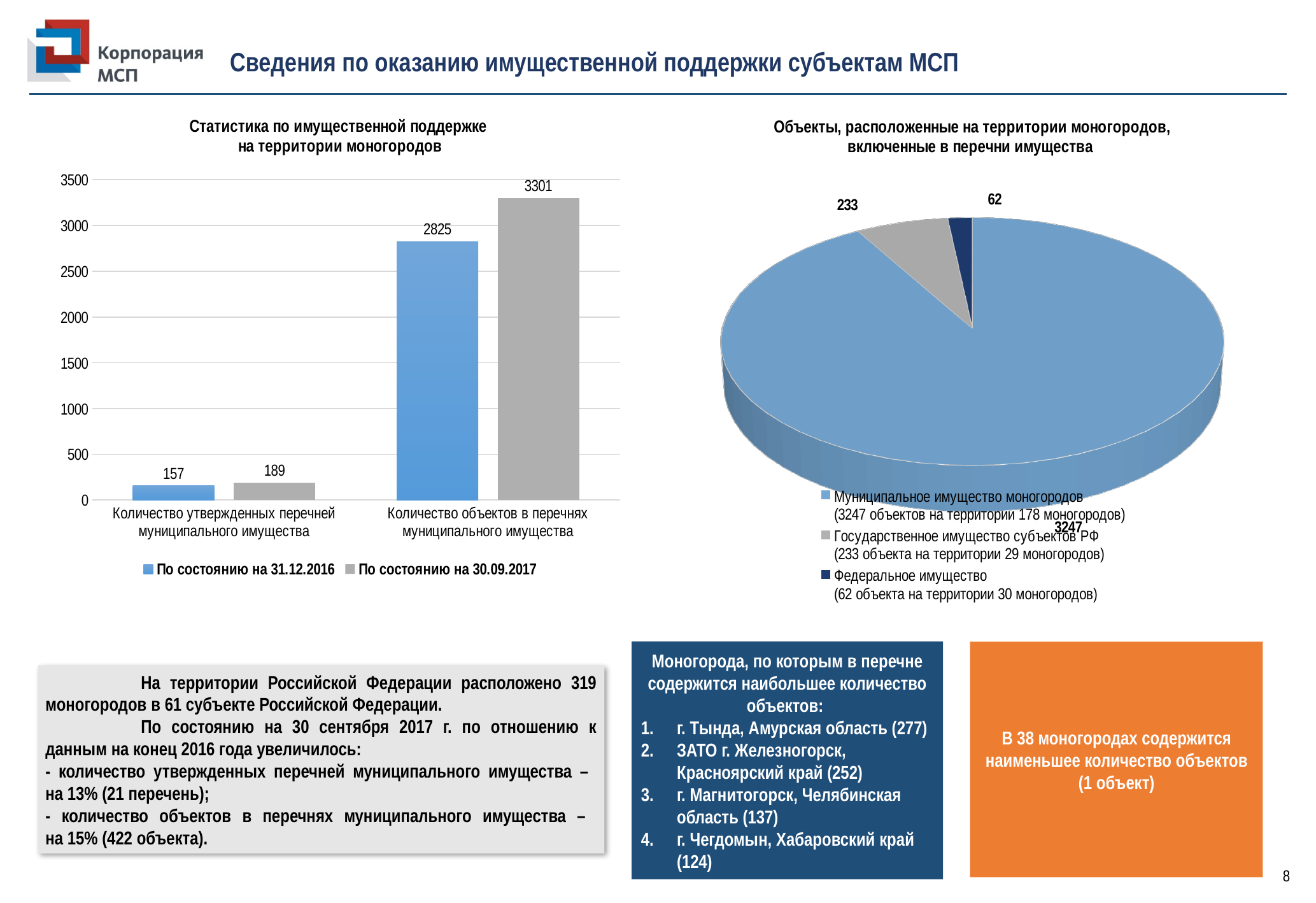
What kind of chart is the right chart 'Объекты, расположенные на территории моногородов, включенные в перечни имущества'? Pie chart In the bar chart 'Статистика по имущественной поддержке на территории моногородов', which series has the larger value for 'Количество объектов в перечнях муниципального имущества'? По состоянию на 30.09.2017 How many slices does the pie chart 'Объекты, расположенные на территории моногородов, включенные в перечни имущества' have? 3 In the bar chart 'Статистика по имущественной поддержке на территории моногородов', what is the difference between the 30.09.2017 and 31.12.2016 values for 'Количество утвержденных перечней муниципального имущества'? 32 What kind of chart is the left chart 'Статистика по имущественной поддержке на территории моногородов'? Bar chart In the bar chart 'Статистика по имущественной поддержке на территории моногородов', what is the value for 'Количество утвержденных перечней муниципального имущества' as of 31.12.2016? 157 How many series does the legend of the bar chart 'Статистика по имущественной поддержке на территории моногородов' list? 2 In the pie chart 'Объекты, расположенные на территории моногородов, включенные в перечни имущества', which category has the largest slice? Муниципальное имущество моногородов In the pie chart 'Объекты, расположенные на территории моногородов, включенные в перечни имущества', what is the value for 'Государственное имущество субъектов РФ'? 233 In the bar chart 'Статистика по имущественной поддержке на территории моногородов', what is the value for 'Количество объектов в перечнях муниципального имущества' as of 30.09.2017? 3301 In the pie chart 'Объекты, расположенные на территории моногородов, включенные в перечни имущества', which category has the smallest slice? Федеральное имущество In the bar chart 'Статистика по имущественной поддержке на территории моногородов', what is the difference between the 30.09.2017 and 31.12.2016 values for 'Количество объектов в перечнях муниципального имущества'? 476